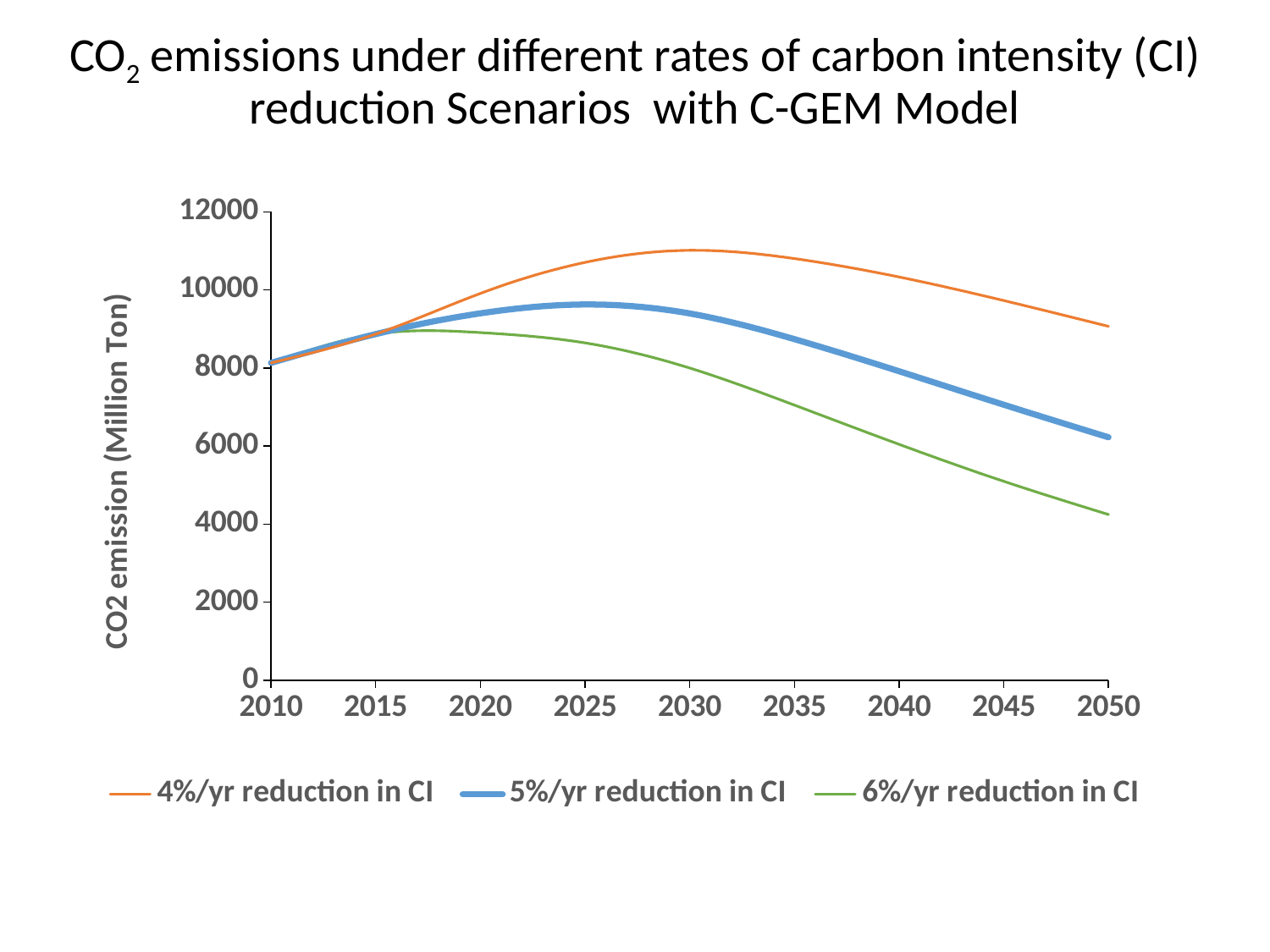
In 2050, which is larger: the value for 4%/yr reduction in CI or the value for 6%/yr reduction in CI? 4%/yr reduction in CI Which series has the highest CO2 emission value in 2050? 4%/yr reduction in CI Does the 6%/yr reduction in CI series rise or fall between 2020 and 2050? fall What kind of chart is shown on the slide? line chart Does the 4%/yr reduction in CI series rise or fall between 2010 and 2030? rise How many series does the legend list? 3 Is the value for the 5%/yr reduction in CI series in 2050 greater or less than 6000? greater Which series has the lowest CO2 emission value in 2050? 6%/yr reduction in CI Is the value for the 4%/yr reduction in CI series in 2030 greater or less than 10000? greater Is the value for the 5%/yr reduction in CI series in 2030 greater or less than 10000? less What is the label on the vertical axis of the chart? CO2 emission (Million Ton)